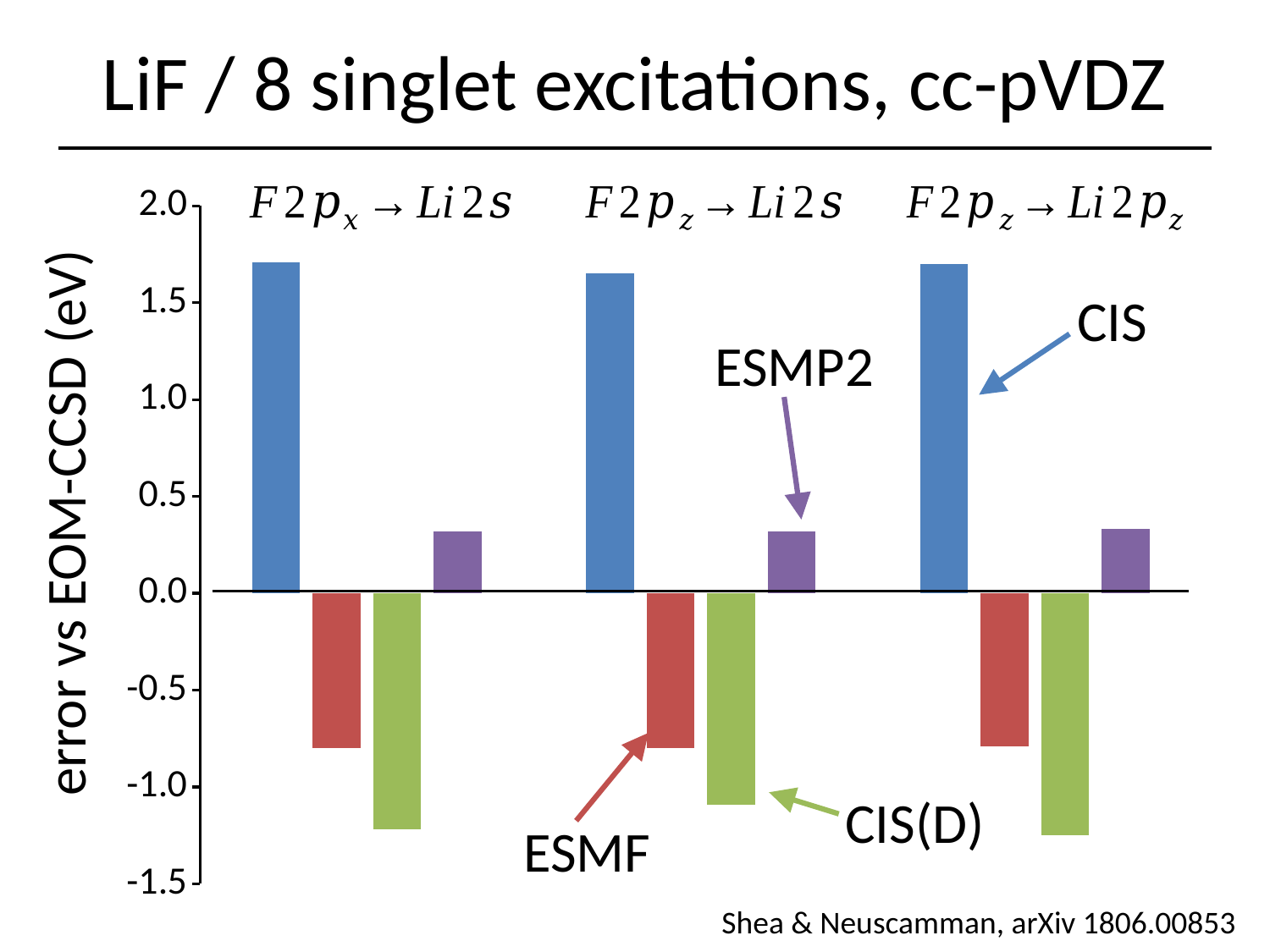
Is the ESMP2 error for the F 2pz → Li 2s excitation greater or less than 0.5 eV? less Is the ESMF error for the F 2pz → Li 2s excitation greater or less than -1.0 eV? greater Is the CIS error for the F 2px → Li 2s excitation greater or less than 1.5 eV? greater For the F 2pz → Li 2s excitation, which has the larger error, CIS or ESMP2? CIS How many methods are labelled on the chart? 4 What kind of chart is shown on the slide? bar chart What is the y-axis label of the chart? error vs EOM-CCSD (eV) How many excitation groups are shown along the x axis? 3 What colour are the CIS bars? blue Which method has the highest error for the F 2px → Li 2s excitation? CIS Which method has the lowest (most negative) error for the F 2pz → Li 2pz excitation? CIS(D)